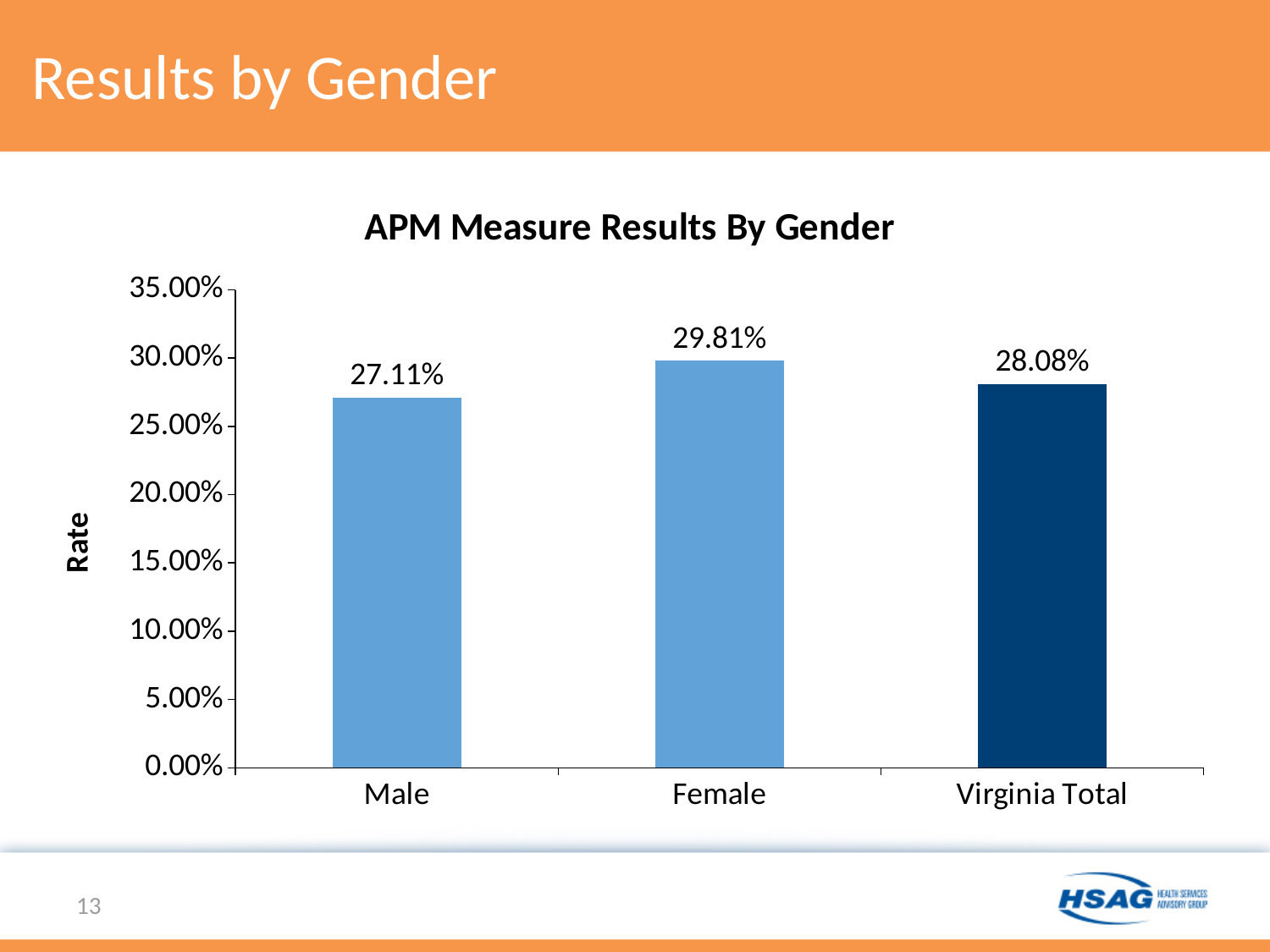
What is the value for Virginia Total? 28.08% What is the title of the chart? APM Measure Results By Gender What kind of chart is shown? bar chart Which category has the lowest value? Male How many categories are shown on the x axis? 3 What is the value for Male? 27.11% What is the difference between the Female and Virginia Total values? 1.73% What is the difference between the Female and Male values? 2.70% Is the value for Female greater or less than 25.00%? greater Which category has the highest value? Female What is the value for Female? 29.81% Which is larger, the value for Male or the value for Virginia Total? Virginia Total